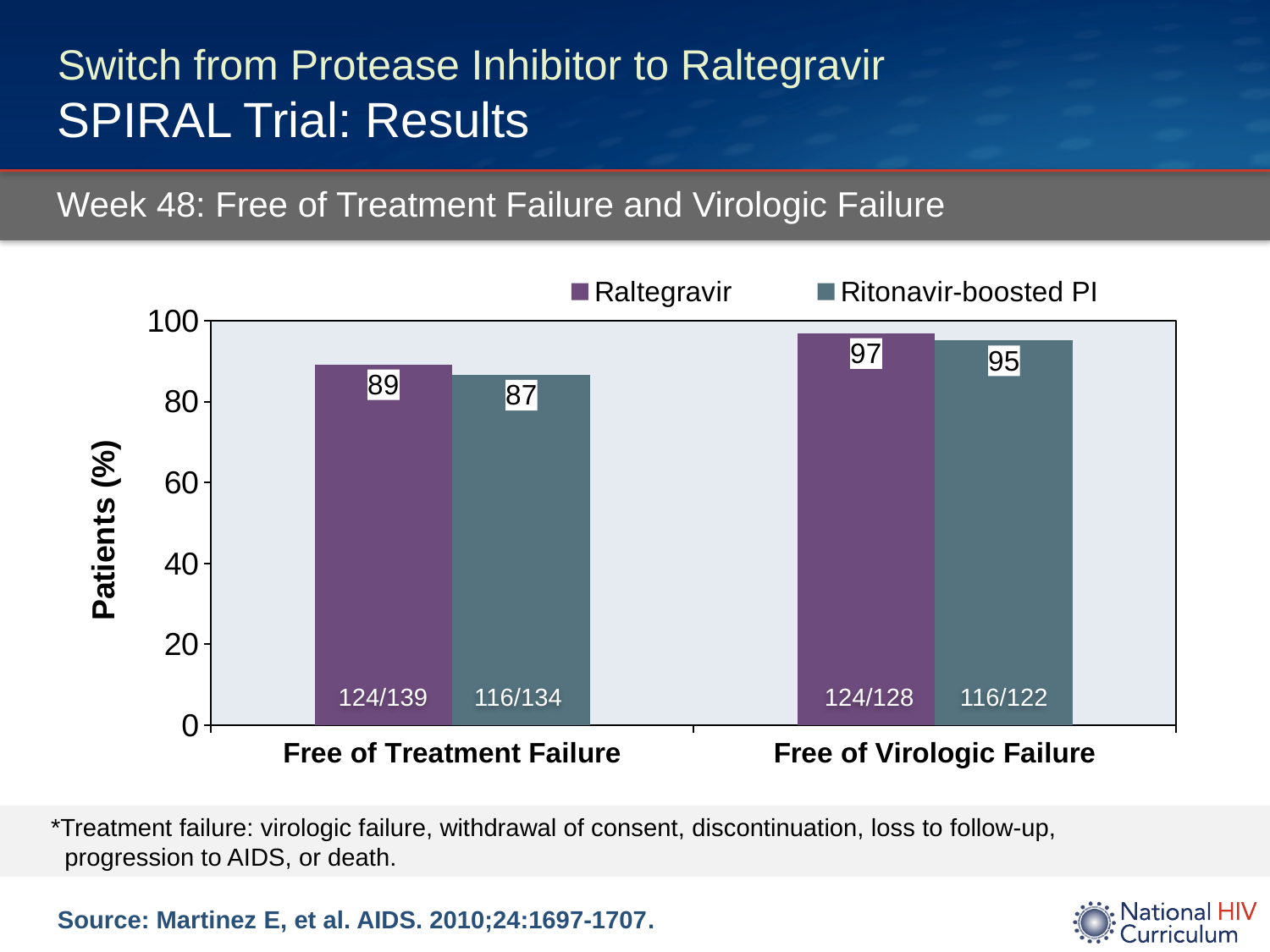
For Free of Treatment Failure, which series has the larger value, Raltegravir or Ritonavir-boosted PI? Raltegravir How many series does the legend list? 2 Which bar shows the highest value on the chart? Raltegravir, Free of Virologic Failure What percentage of Raltegravir patients were free of treatment failure? 89 What is the label of the y axis? Patients (%) How many categories are shown on the x axis? 2 Which bar shows the lowest value on the chart? Ritonavir-boosted PI, Free of Treatment Failure What percentage of Ritonavir-boosted PI patients were free of virologic failure? 95 What percentage of Ritonavir-boosted PI patients were free of treatment failure? 87 What kind of chart is shown on the slide? Bar chart What fraction of patients is shown inside the Raltegravir bar for Free of Virologic Failure? 124/128 What is the difference between the Raltegravir and Ritonavir-boosted PI values for Free of Virologic Failure? 2